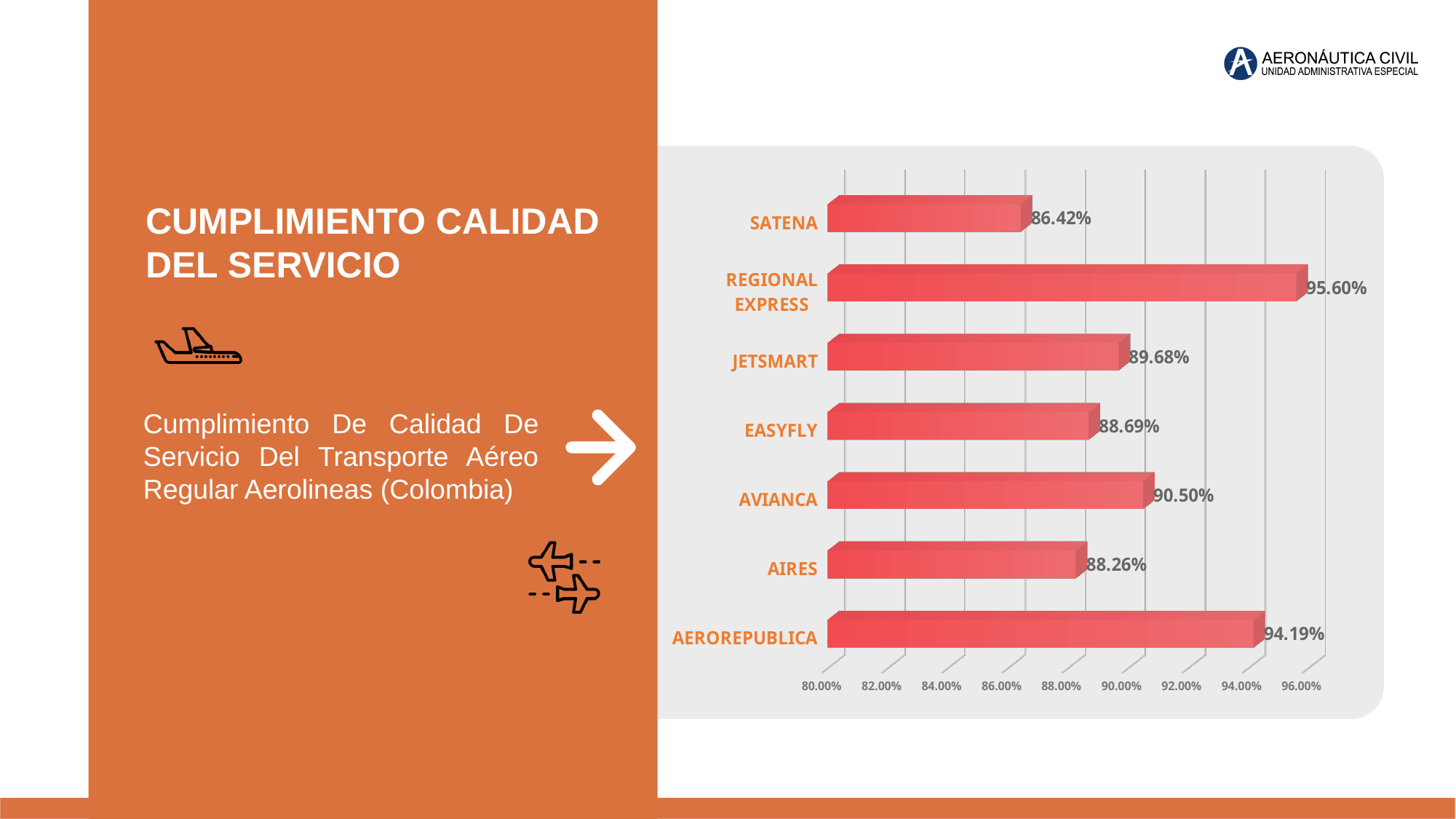
What is the difference between the values for REGIONAL EXPRESS and AEROREPUBLICA? 1.41% What is the difference between the values for JETSMART and EASYFLY? 0.99% What kind of chart is shown on the slide? bar chart Which airline has the lowest value? SATENA Which airline has the highest value? REGIONAL EXPRESS What is the value for AEROREPUBLICA? 94.19% What is the value for SATENA? 86.42% What is the value for AVIANCA? 90.50% What is the value for REGIONAL EXPRESS? 95.60% Which is larger, the value for AVIANCA or the value for AIRES? AVIANCA How many airlines are shown in the chart? 7 Is the value for EASYFLY greater or less than 90.00%? less